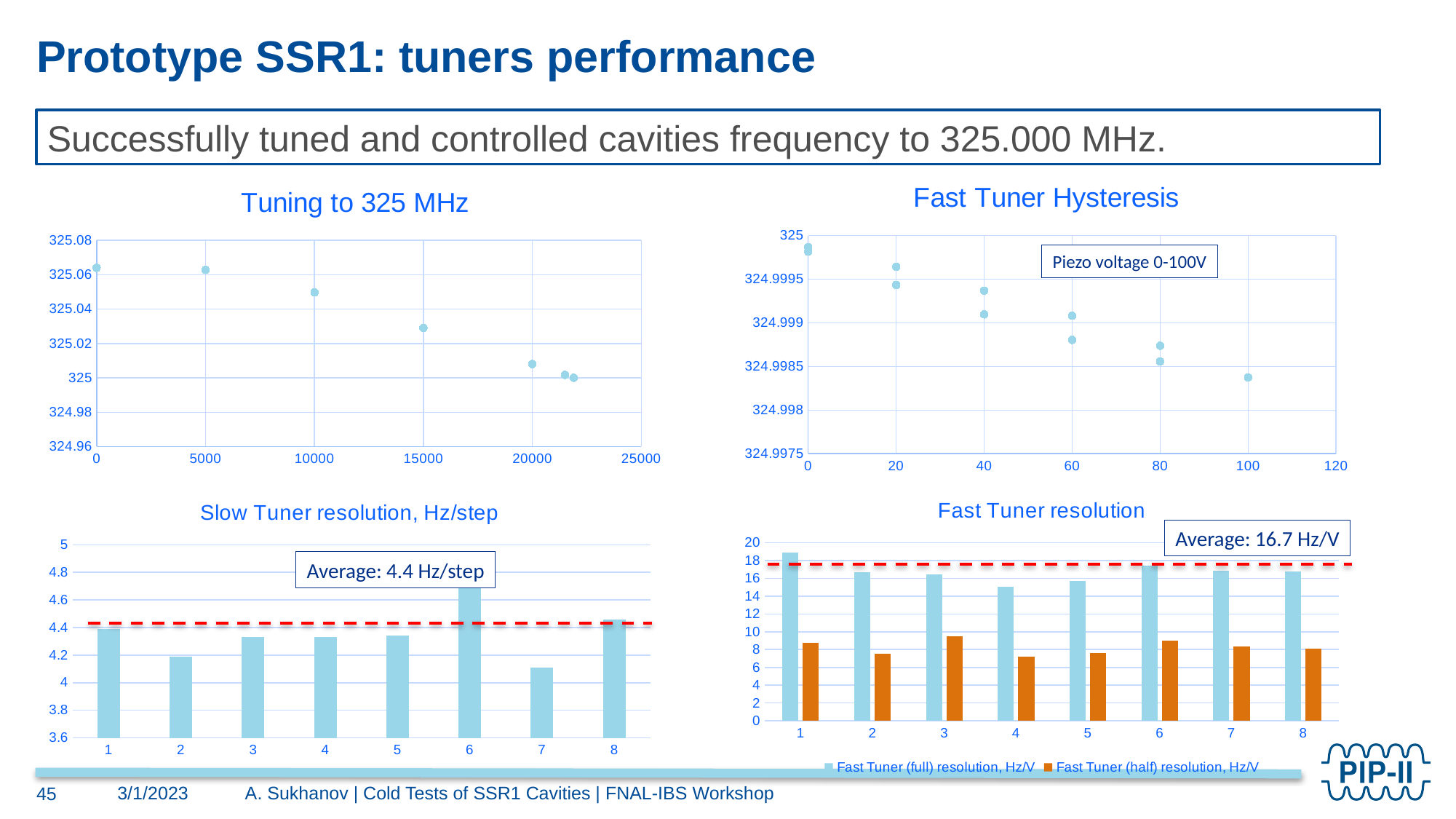
In the 'Slow Tuner resolution, Hz/step' chart, is the value for category 6 greater or less than 4.6? greater How many categories are shown on the x axis of the 'Slow Tuner resolution, Hz/step' chart? 8 In the 'Tuning to 325 MHz' chart, do the plotted values rise or fall as the x axis increases? fall In the 'Fast Tuner resolution' chart, which category has the highest 'Fast Tuner (full) resolution, Hz/V' bar? 1 In the 'Slow Tuner resolution, Hz/step' chart, which category has the lowest bar? 7 In the 'Fast Tuner resolution' chart, is the 'Fast Tuner (full) resolution, Hz/V' value for category 4 greater or less than 16? less What average value is annotated on the 'Fast Tuner resolution' chart? 16.7 Hz/V What kind of chart is the 'Tuning to 325 MHz' chart? scatter chart In the 'Fast Tuner resolution' chart, for category 1, which is larger: the full resolution bar or the half resolution bar? Fast Tuner (full) resolution, Hz/V What kind of chart is the 'Slow Tuner resolution, Hz/step' chart? bar chart In the 'Fast Tuner resolution' chart, how many series does the legend list? 2 In the 'Slow Tuner resolution, Hz/step' chart, which category has the highest bar? 6